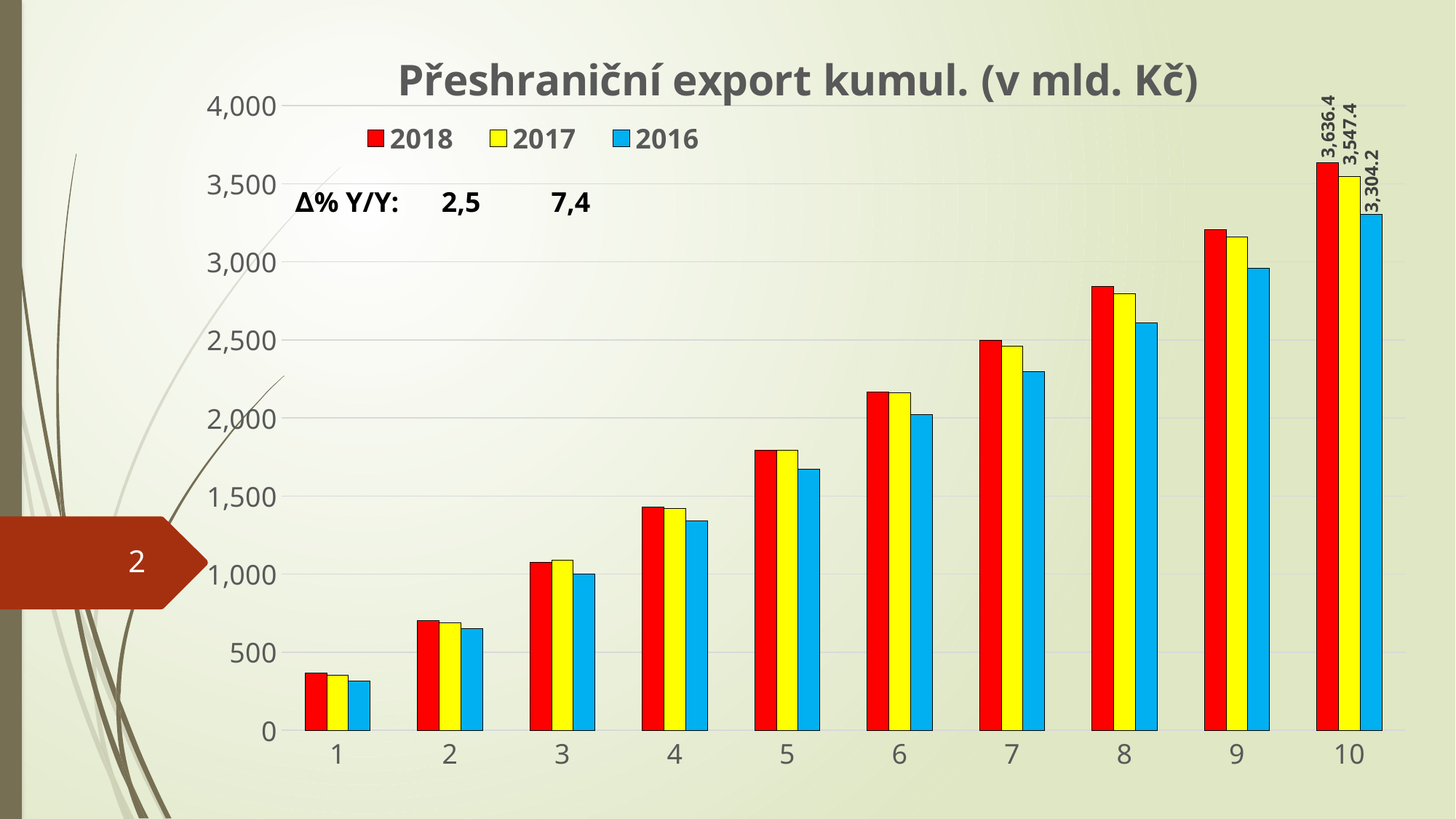
How many series does the legend list? 3 What is the value of the 2018 series at category 10? 3,636.4 What is the value of the 2017 series at category 10? 3,547.4 Is the 2018 value at category 8 greater or less than 2,500? greater How many categories are shown on the x axis? 10 Is the 2016 value at category 5 greater or less than 2,000? less Do the values of the 2018 series rise or fall from category 1 to category 10? rise At category 10, what is the difference between the 2018 value and the 2016 value? 332.2 What is the title of the chart? Přeshraniční export kumul. (v mld. Kč) What is the value of the 2016 series at category 10? 3,304.2 At category 10, which series has the larger value, 2018 or 2016? 2018 What kind of chart is shown on the slide? bar chart